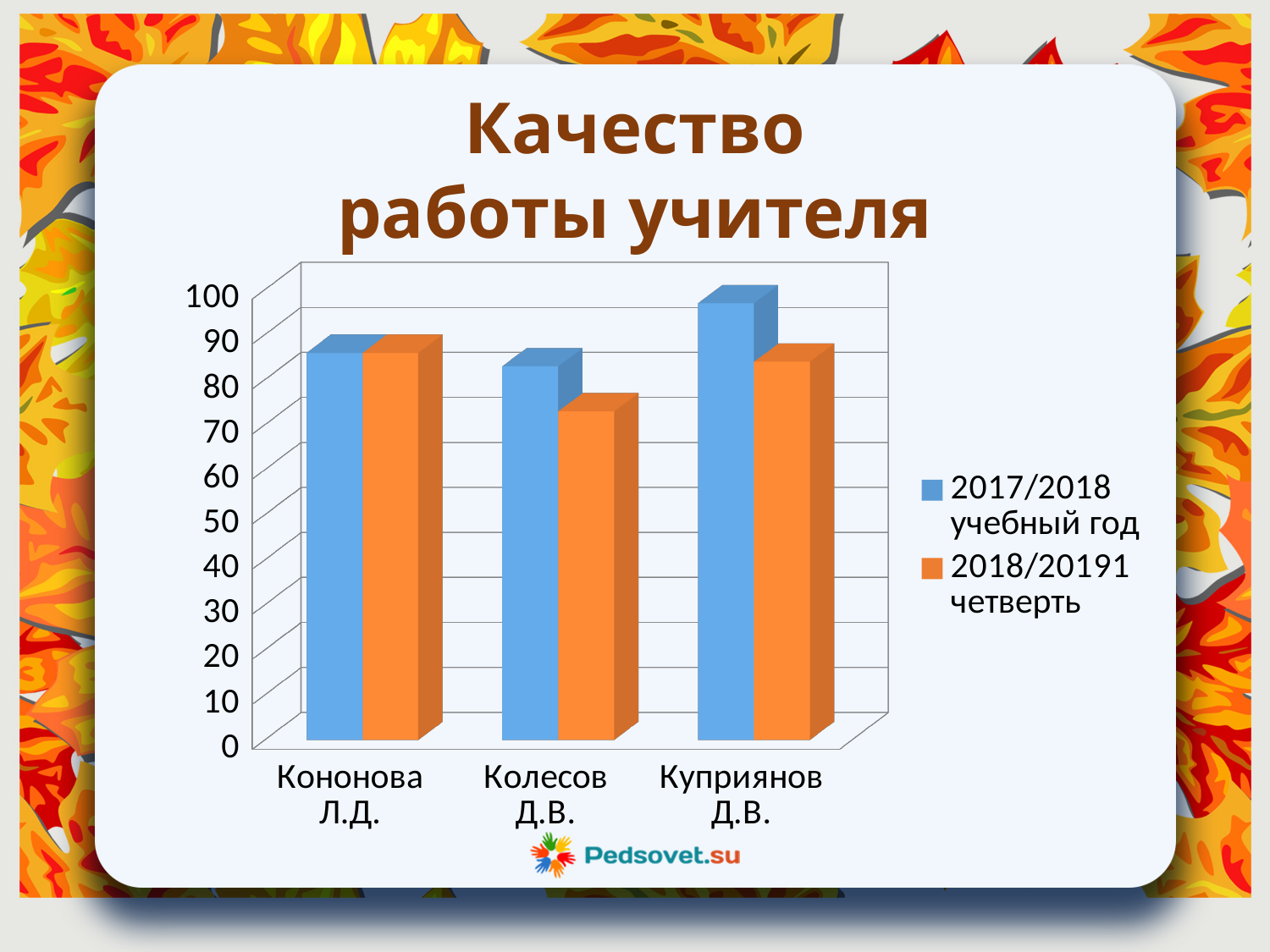
For Куприянов Д.В., which is larger: the 2017/2018 учебный год value or the 2018/2019 1 четверть value? 2017/2018 учебный год Is the 2017/2018 учебный год value for Куприянов Д.В. greater or less than 90? greater Is the 2017/2018 учебный год value for Кононова Л.Д. greater or less than 80? greater What kind of chart is shown on the slide? bar chart How many series does the legend list? 2 Which teacher has the lowest value for 2018/2019 1 четверть? Колесов Д.В. Which teacher has the lowest value for 2017/2018 учебный год? Колесов Д.В. Is the 2018/2019 1 четверть value for Колесов Д.В. greater or less than 80? less Which teacher has the highest value for 2017/2018 учебный год? Куприянов Д.В. How many teachers (categories) are shown on the x axis? 3 For Колесов Д.В., which is larger: the 2017/2018 учебный год value or the 2018/2019 1 четверть value? 2017/2018 учебный год What is the title of the chart? Качество работы учителя